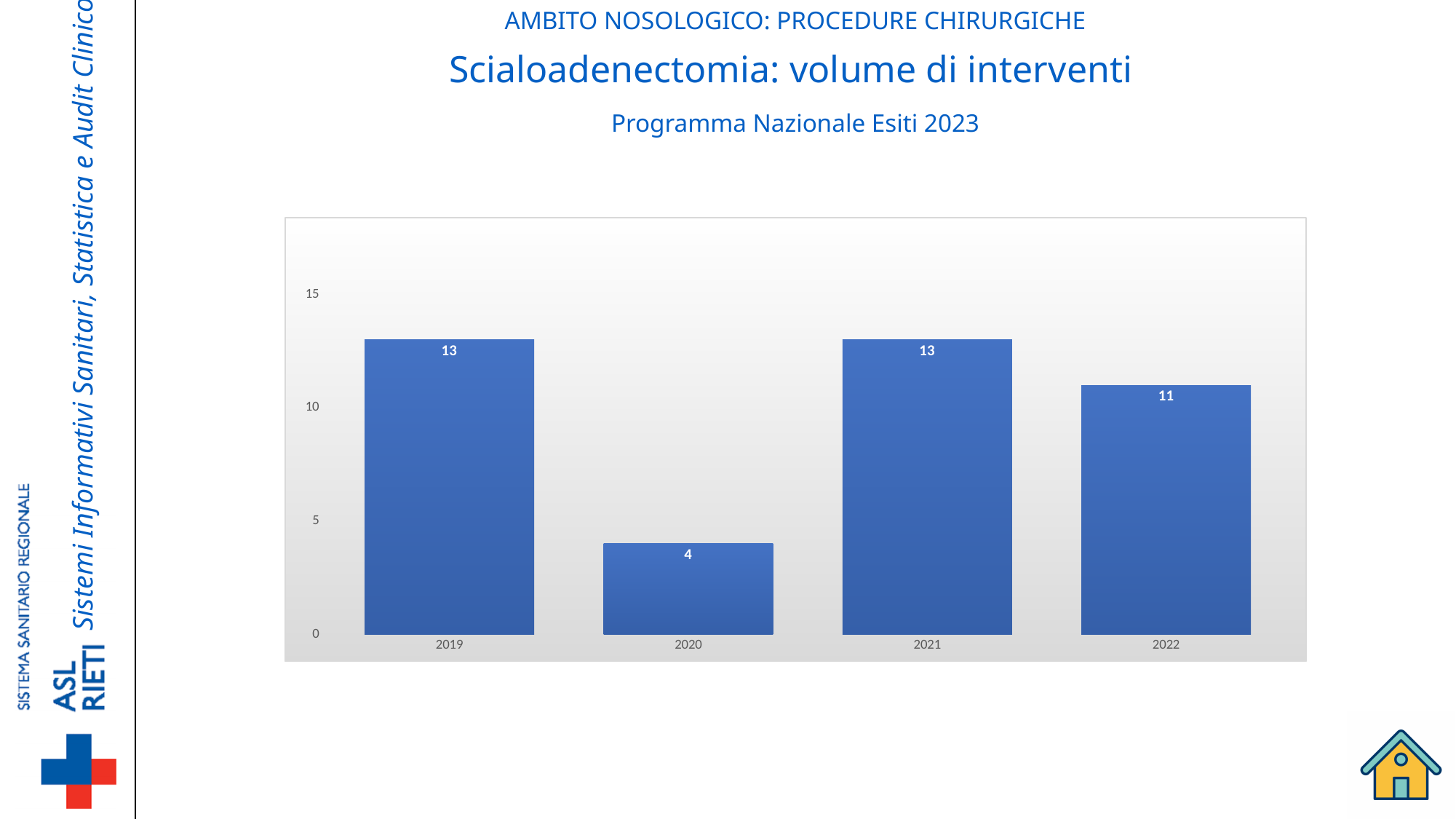
What is the value for 2019? 13 Which year has the lowest value? 2020 What is the difference between the values for 2021 and 2020? 9 What is the value for 2020? 4 How many years are shown on the x axis? 4 What kind of chart is shown on the slide? bar chart What is the difference between the values for 2019 and 2022? 2 What is the value for 2022? 11 What is the total of the values for all four years? 41 Is the value for 2020 greater or less than 5? less Is the value for 2021 greater or less than 10? greater Which is larger, the value for 2022 or the value for 2020? 2022